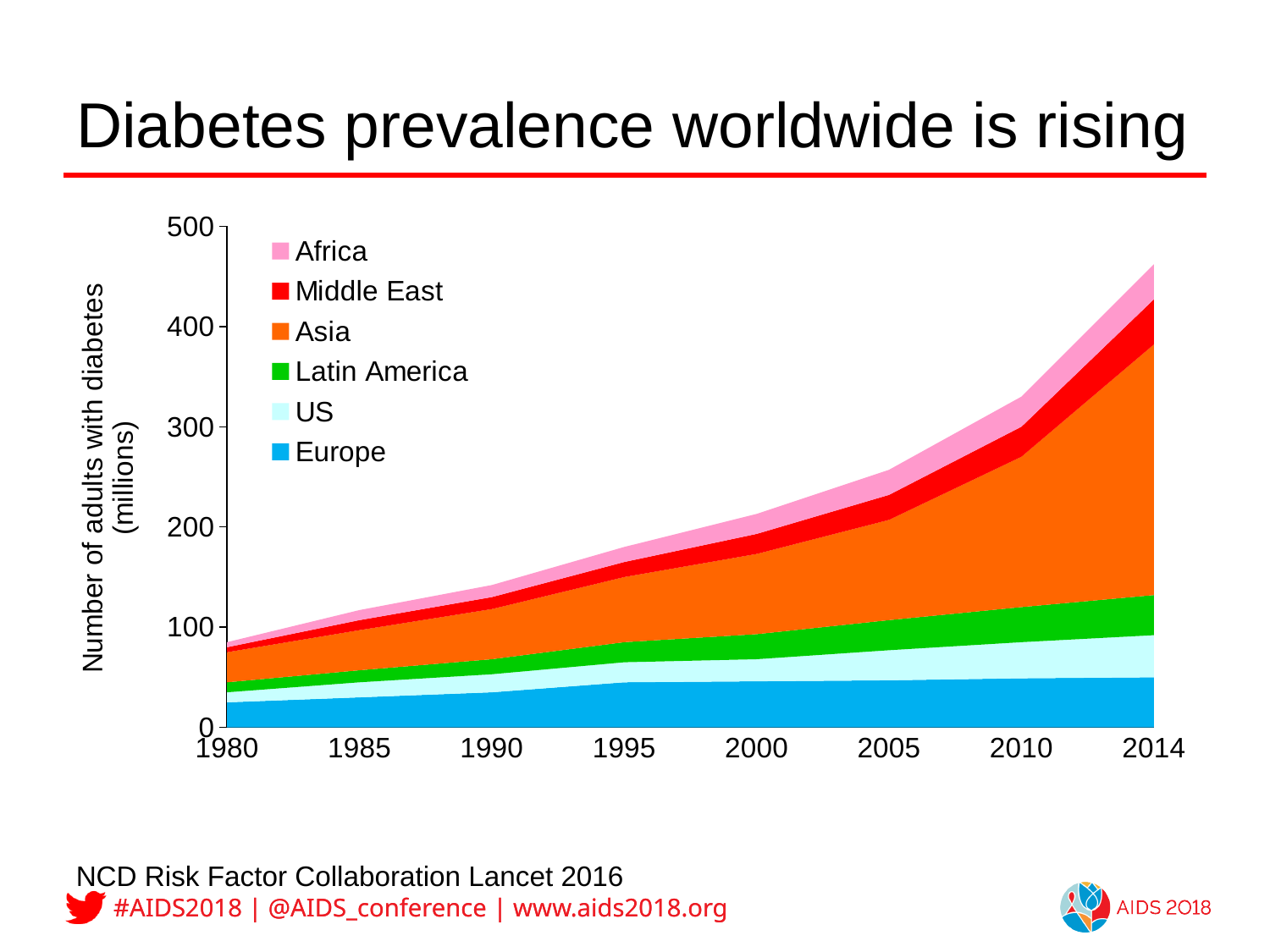
What kind of chart is shown on the slide? Stacked area chart Is the total number of adults with diabetes in 2014 greater or less than 400 million? greater Is the total number of adults with diabetes in 2010 greater or less than 300 million? greater Is the total number of adults with diabetes in 1980 greater or less than 100 million? less Does the total number of adults with diabetes rise or fall from 1980 to 2014? Rise What is the label on the y axis? Number of adults with diabetes (millions) Which region accounts for the largest share of adults with diabetes in 2014? Asia Which is larger in 2014, the Asia band or the Europe band? Asia Which region is listed first in the legend? Africa How many series does the legend list? 6 How many year labels are shown on the x axis? 8